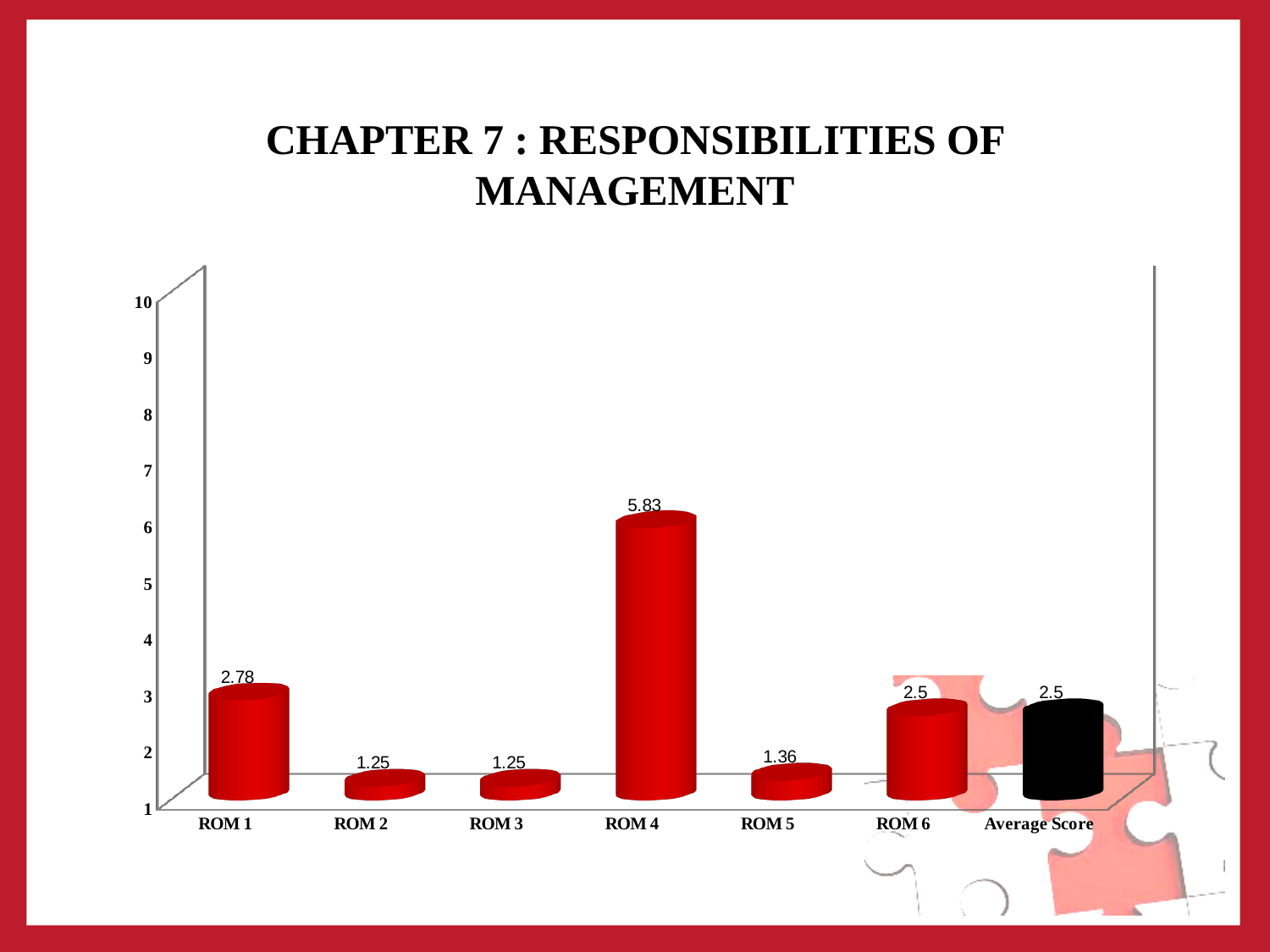
Is the value for ROM 4 greater or less than 5? greater What is the difference between the values for ROM 4 and ROM 1? 3.05 What is the value for ROM 5? 1.36 Which is larger, the value for ROM 1 or the value for ROM 6? ROM 1 What is the Average Score shown on the chart? 2.5 What colour is the Average Score bar? black What is the difference between the values for ROM 5 and ROM 2? 0.11 Which category has the highest value? ROM 4 How many categories are shown on the x axis? 7 What is the value for ROM 1? 2.78 What is the value for ROM 4? 5.83 What kind of chart is shown on the slide? bar chart